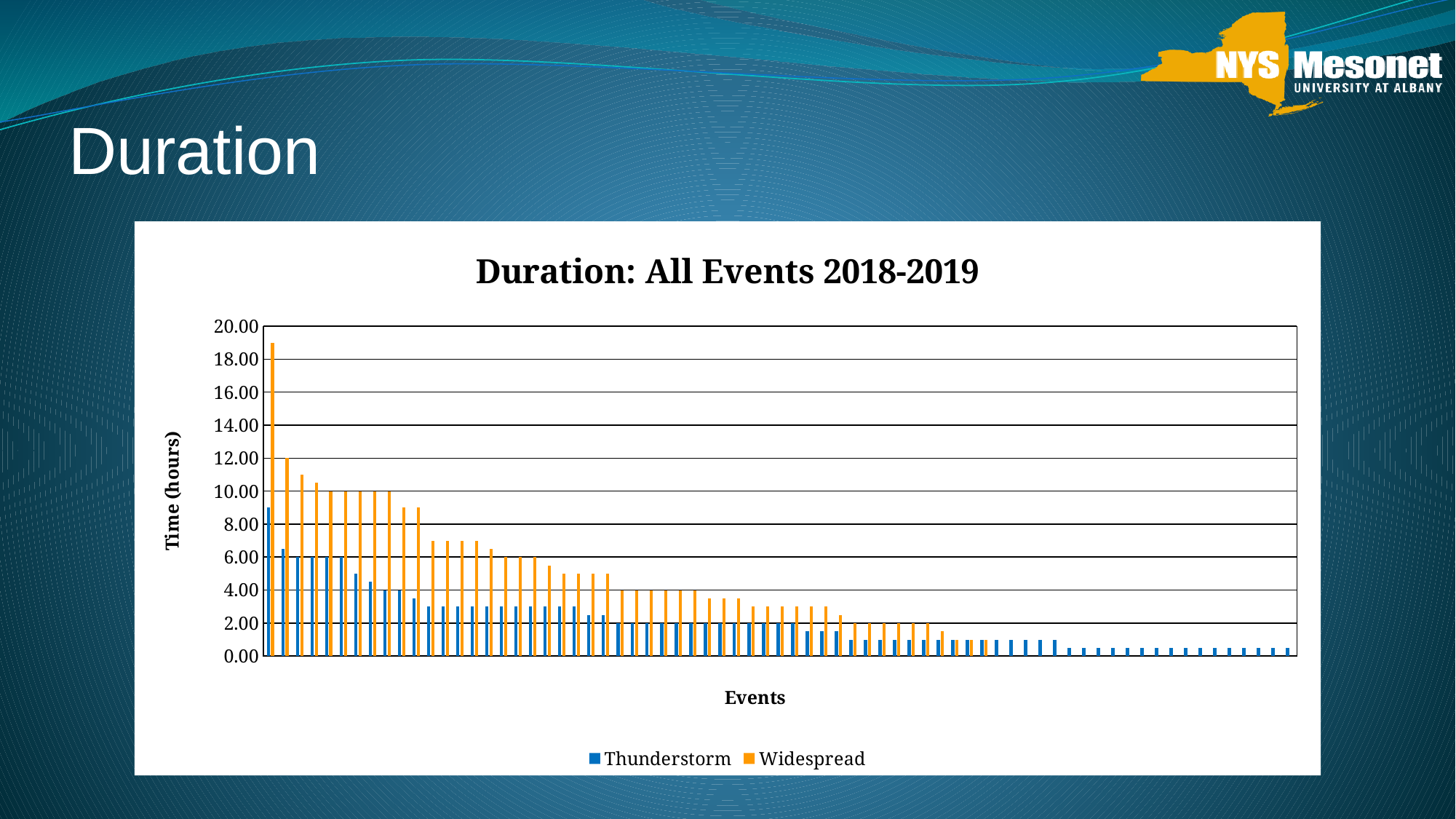
How many series does the legend list? 2 Do the bar values rise or fall moving from left to right along the x axis? fall What is the highest value shown on the vertical axis? 20.00 Which series contains the tallest bar on the chart, Thunderstorm or Widespread? Widespread What kind of chart is shown on the slide? bar chart Which is larger, the tallest Widespread bar or the tallest Thunderstorm bar? the tallest Widespread bar Is the tallest Thunderstorm bar greater or less than 8.00 hours? greater What is the label on the vertical axis? Time (hours) What is the title of the chart? Duration: All Events 2018-2019 Is the tallest Thunderstorm bar greater or less than 10.00 hours? less Is the tallest Widespread bar greater or less than 18.00 hours? greater